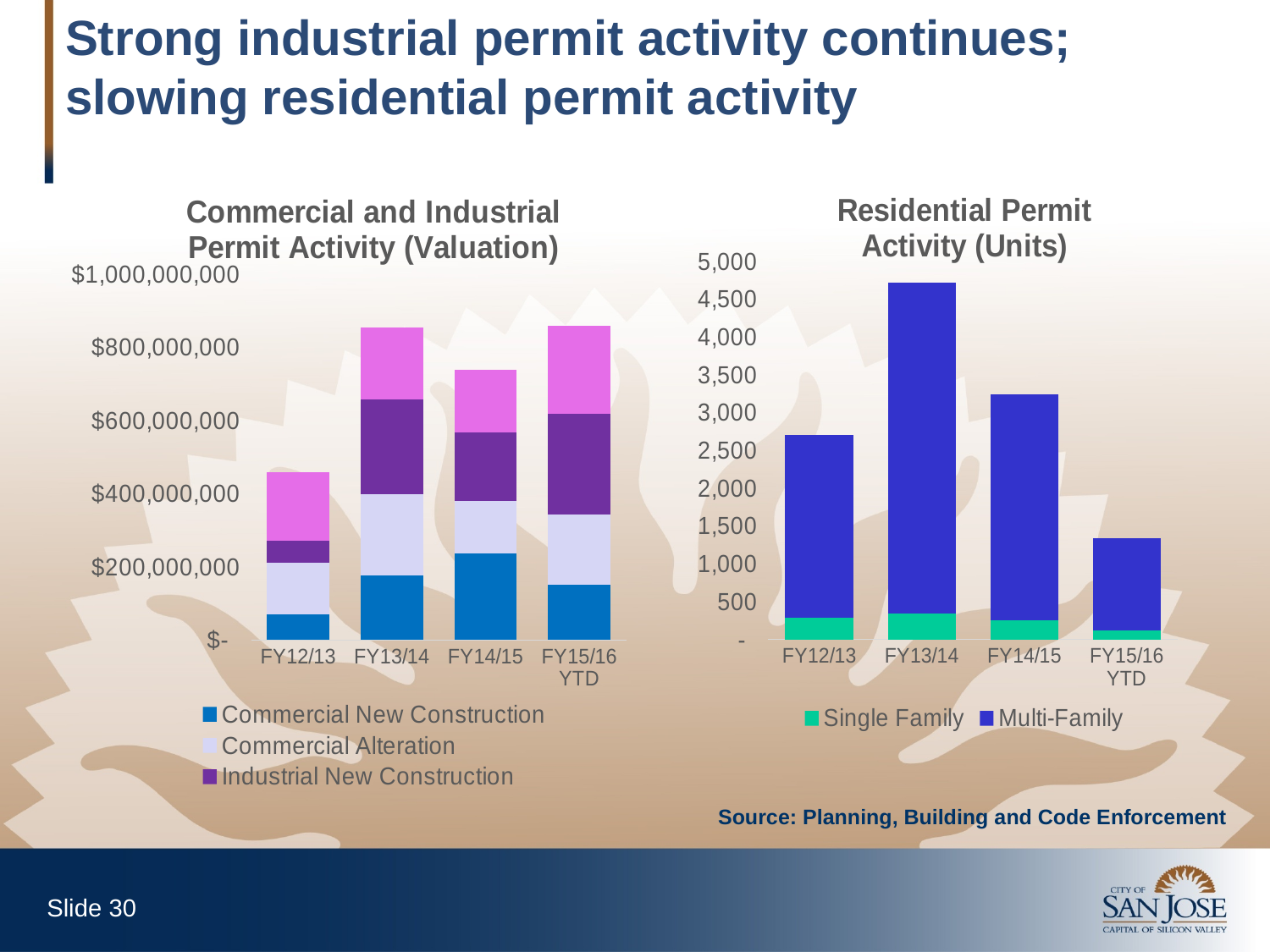
In the 'Residential Permit Activity (Units)' chart, is the total for FY13/14 greater or less than 4,500? greater How many series does the legend of the 'Residential Permit Activity (Units)' chart list? 2 In the 'Residential Permit Activity (Units)' chart, do the bar totals rise or fall from FY13/14 to FY15/16 YTD? fall What kind of chart is the 'Residential Permit Activity (Units)' chart? stacked bar chart Which series is shown in green in the 'Residential Permit Activity (Units)' chart? Single Family In the 'Residential Permit Activity (Units)' chart, which fiscal year has the tallest bar? FY13/14 In the 'Commercial and Industrial Permit Activity (Valuation)' chart, is the total for FY14/15 greater or less than $600,000,000? greater How many fiscal-year categories are shown on the x axis of the 'Commercial and Industrial Permit Activity (Valuation)' chart? 4 In the 'Residential Permit Activity (Units)' chart, which bar is taller, FY12/13 or FY14/15? FY14/15 In the 'Commercial and Industrial Permit Activity (Valuation)' chart, which fiscal year has the lowest total valuation? FY12/13 In the 'Residential Permit Activity (Units)' chart, is the total for FY15/16 YTD greater or less than 1,500? less In the 'Residential Permit Activity (Units)' chart, which fiscal year has the shortest bar? FY15/16 YTD